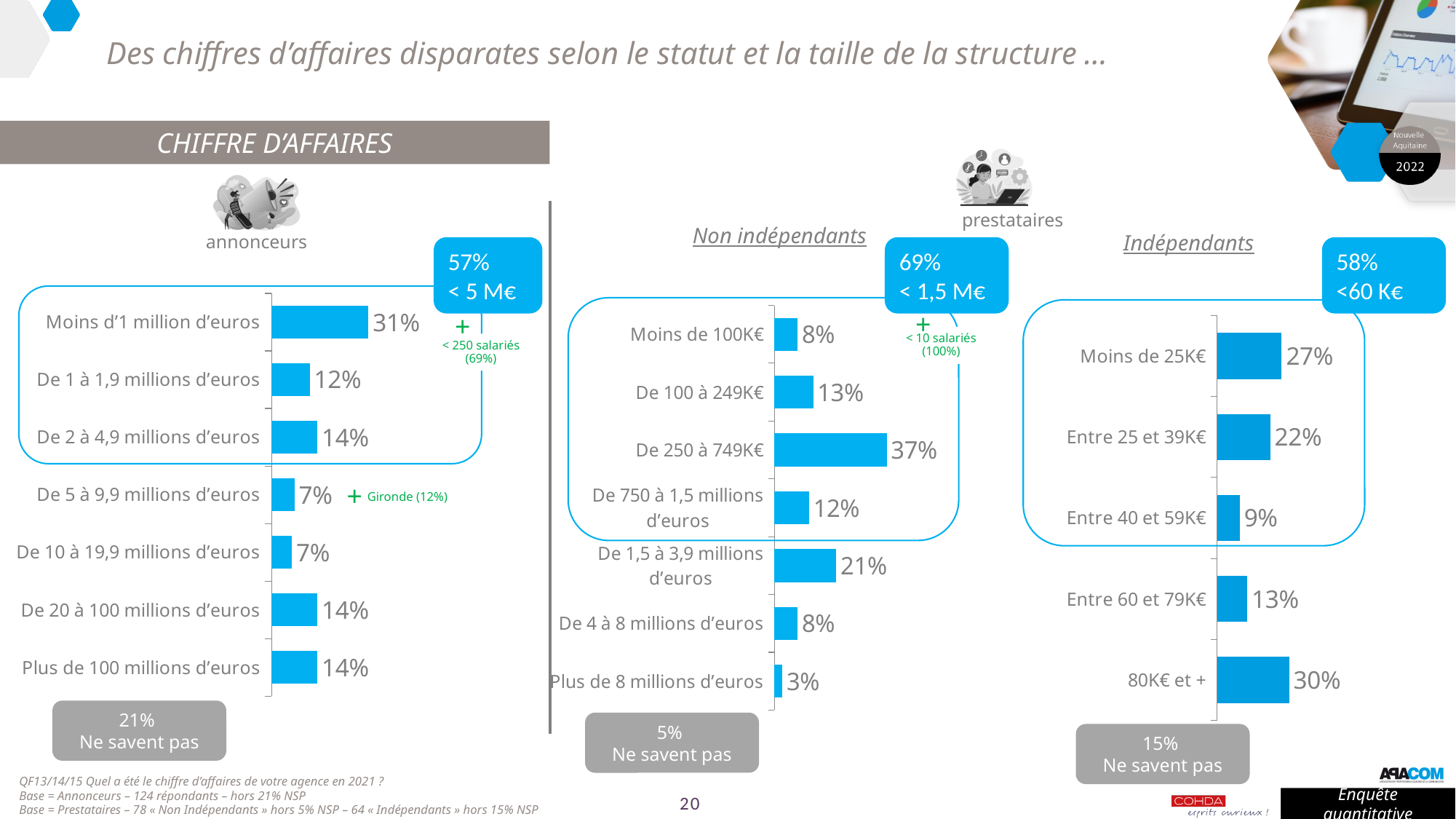
In the Indépendants chart, what is the value for "80K€ et +"? 30% In the annonceurs chart, what is the value for "Moins d'1 million d'euros"? 31% In the annonceurs chart, how many categories are plotted? 7 In the Indépendants chart, how many categories are plotted? 5 What type of chart is the Indépendants chart? Bar chart In the annonceurs chart, what is the difference between "Moins d'1 million d'euros" and "De 1 à 1,9 millions d'euros"? 19 percentage points In the Non indépendants chart, which is larger: "De 1,5 à 3,9 millions d'euros" or "De 100 à 249K€"? De 1,5 à 3,9 millions d'euros In the Non indépendants chart, which category has the lowest value? Plus de 8 millions d'euros In the Non indépendants chart, what is the value for "De 250 à 749K€"? 37% In the annonceurs chart, which category has the highest value? Moins d'1 million d'euros In the Indépendants chart, what is the difference between "Moins de 25K€" and "Entre 25 et 39K€"? 5 percentage points In the Indépendants chart, which category has the lowest value? Entre 40 et 59K€